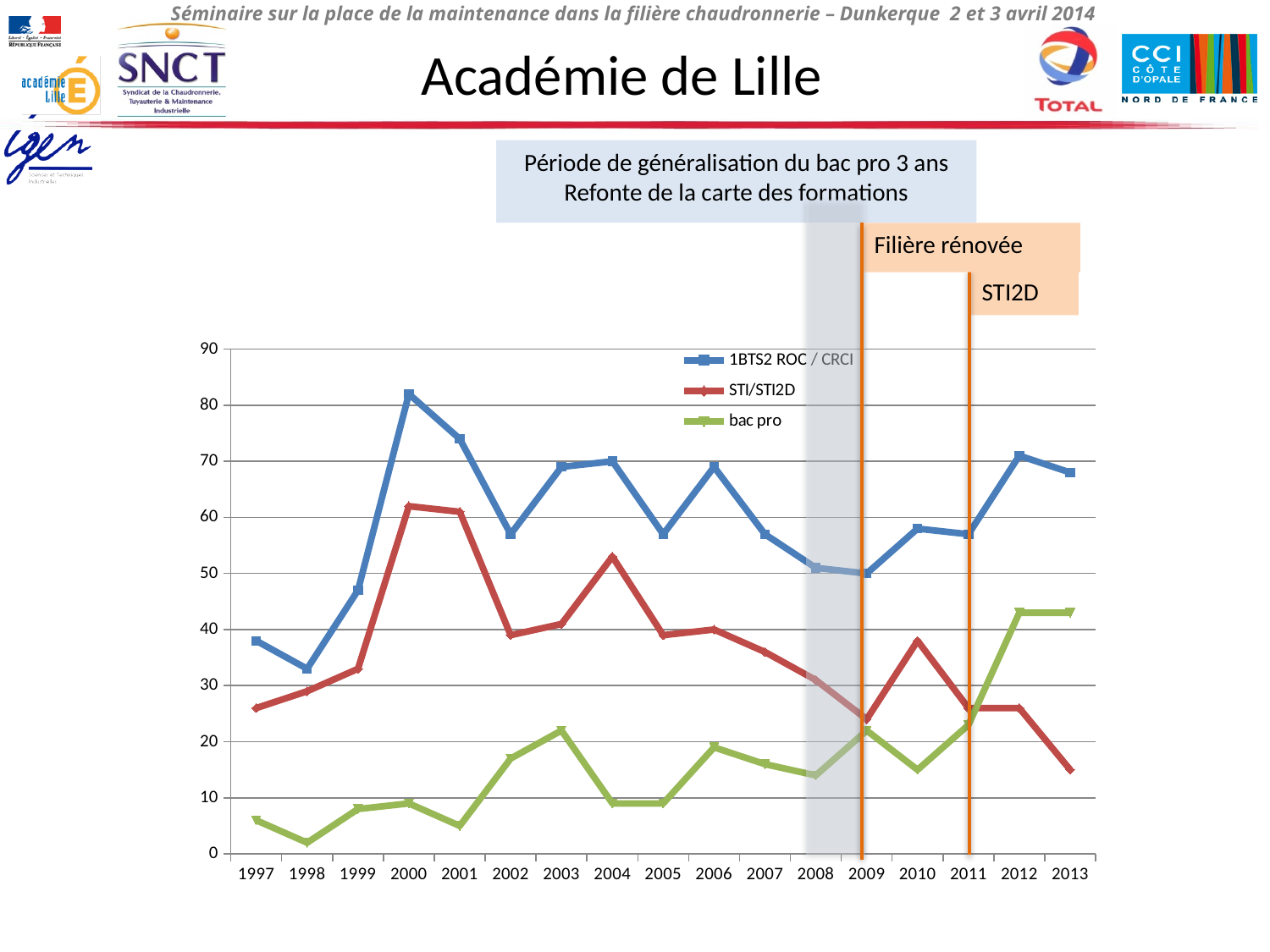
Is the value for STI/STI2D in 2013 greater or less than 20? less What are the three series named in the chart legend? 1BTS2 ROC / CRCI, STI/STI2D, bac pro What kind of chart is shown on the slide? line chart In which year does the 1BTS2 ROC / CRCI series reach its highest value? 2000 In 2013, which series has the larger value: bac pro or STI/STI2D? bac pro Is the value for 1BTS2 ROC / CRCI in 2000 greater or less than 70? greater How many years are plotted along the x axis of the chart? 17 Is the value for bac pro in 2012 greater or less than 40? greater In which year does the STI/STI2D series reach its highest value? 2000 How many series does the chart legend list? 3 In which year is the bac pro series at its lowest value? 1998 Does the bac pro series rise or fall between 2010 and 2013? rise